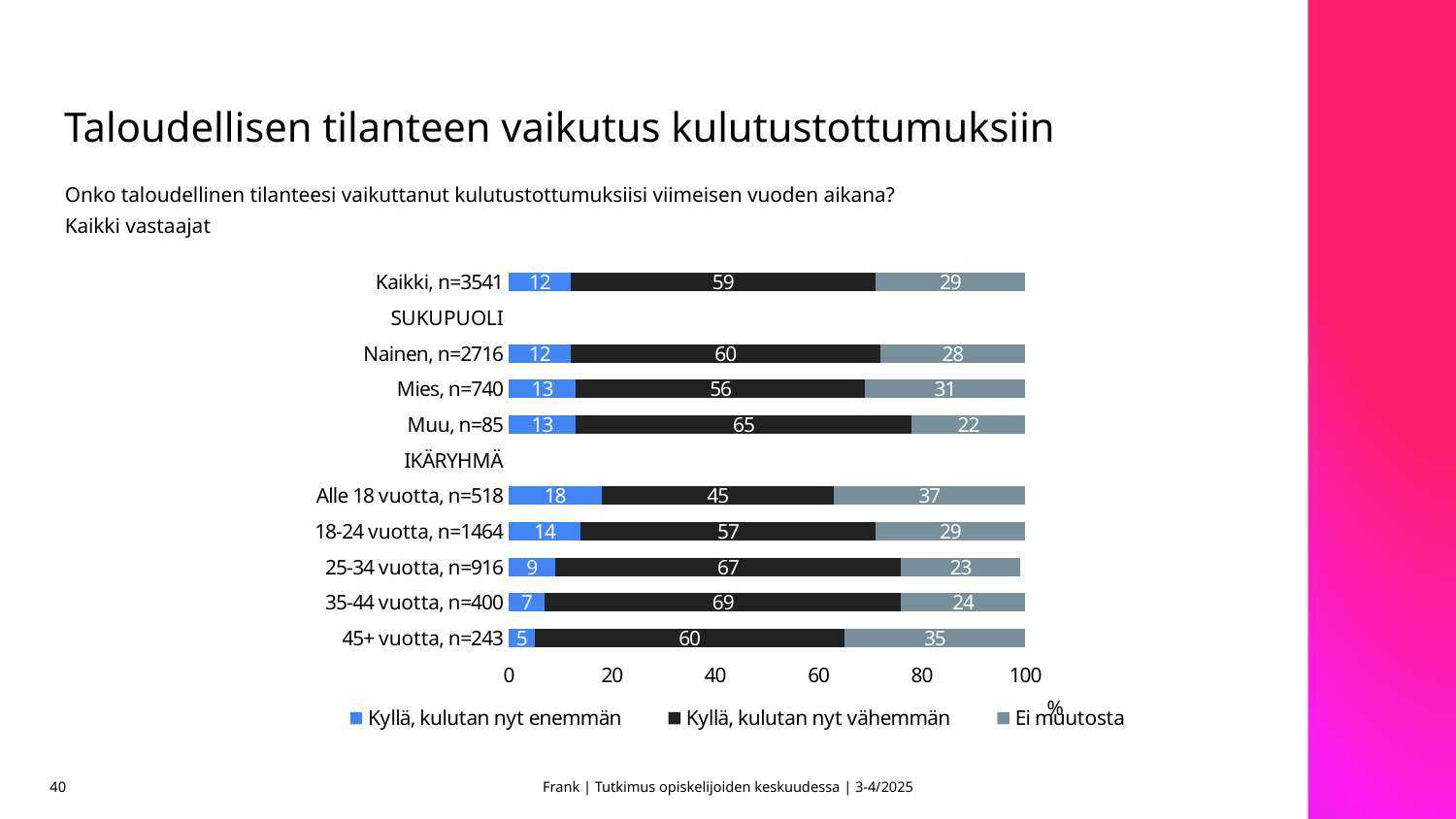
What is the value of "Kyllä, kulutan nyt enemmän" for 45+ vuotta, n=243? 5 What is the total of the stacked bar for 18-24 vuotta, n=1464? 100 Which group has the highest value for "Kyllä, kulutan nyt enemmän"? Alle 18 vuotta, n=518 How many series does the legend list? 3 Which legend entry is shown in blue? Kyllä, kulutan nyt enemmän What is the difference between the "Ei muutosta" values for Mies, n=740 and Nainen, n=2716? 3 What is the value of "Kyllä, kulutan nyt vähemmän" for Kaikki, n=3541? 59 What type of chart is shown on the slide? Stacked bar chart Which group has the lowest value for "Kyllä, kulutan nyt vähemmän"? Alle 18 vuotta, n=518 What is the value of "Kyllä, kulutan nyt vähemmän" for Muu, n=85? 65 What is the value of "Ei muutosta" for Alle 18 vuotta, n=518? 37 Which is larger: the "Kyllä, kulutan nyt vähemmän" value for 35-44 vuotta, n=400 or for 25-34 vuotta, n=916? 35-44 vuotta, n=400